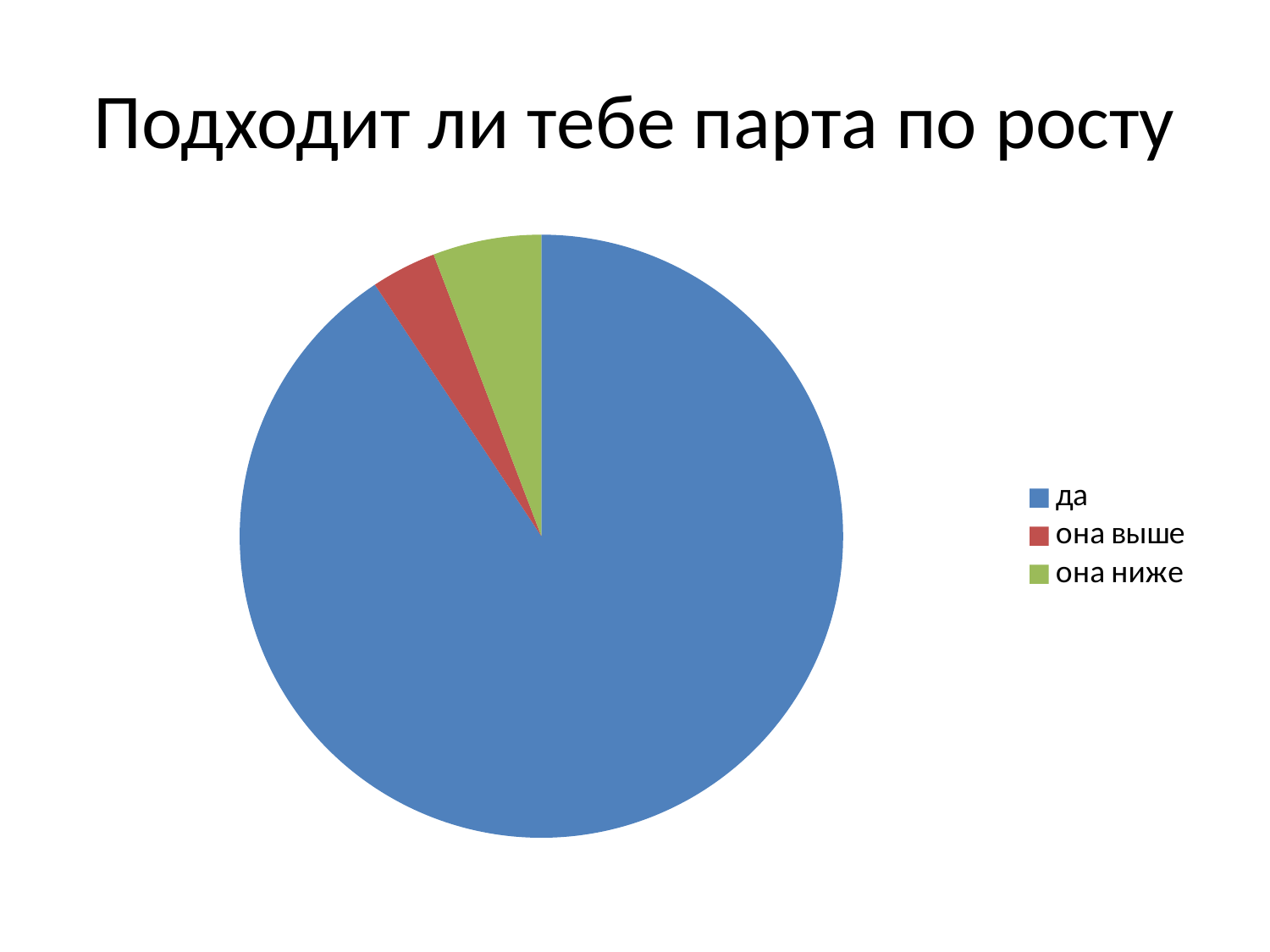
What colour is the slice for "да"? blue Which category has the largest slice of the pie? да Which category has the smallest slice of the pie? она выше What kind of chart is shown on the slide? pie chart Which slice is larger, "да" or "она ниже"? да Which slice is larger, "она выше" or "да"? да How many categories does the pie chart have? 3 Which slice is larger, "она ниже" or "она выше"? она ниже What is the title of the chart? Подходит ли тебе парта по росту How many entries does the legend list? 3